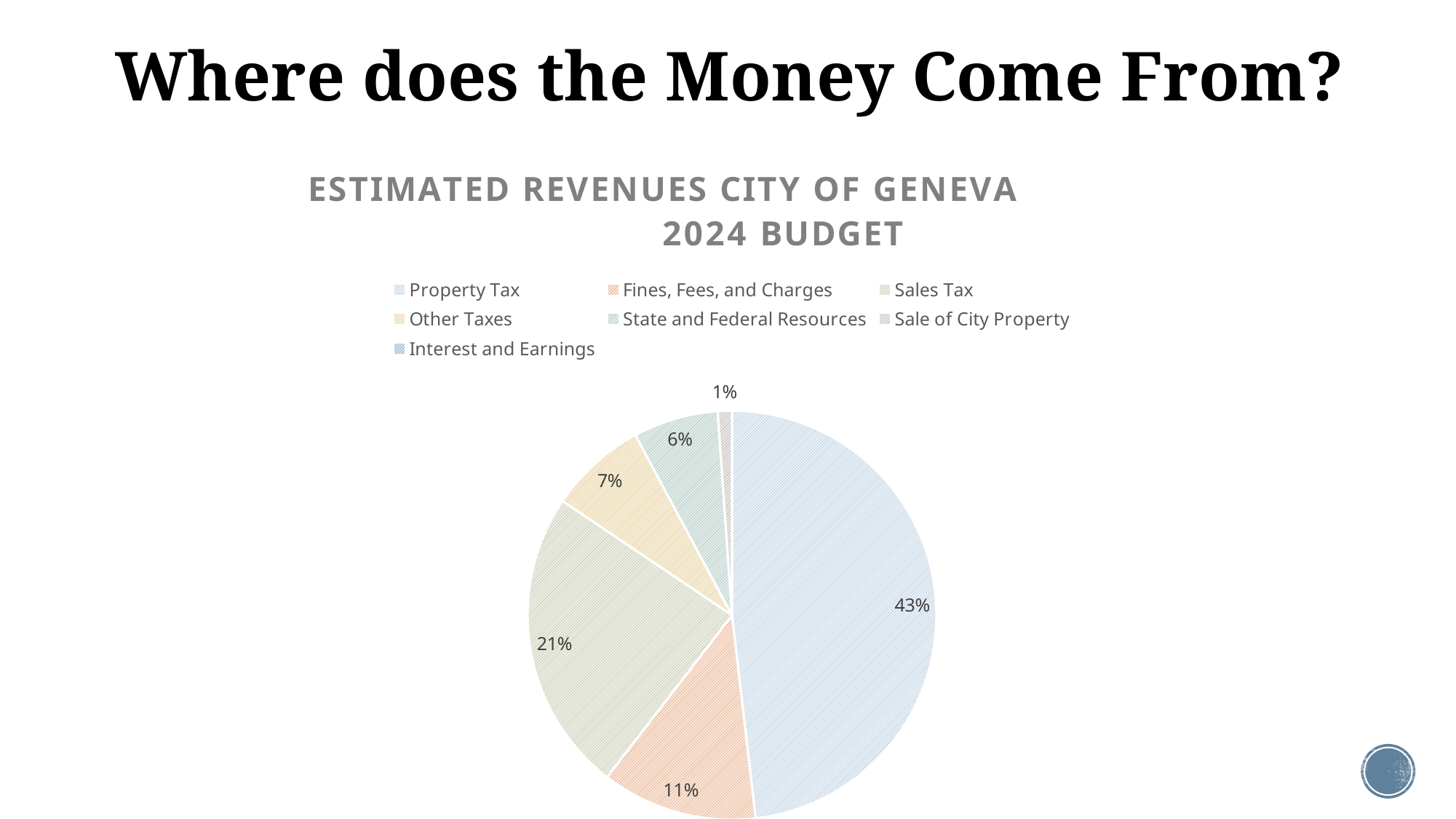
What is the difference in percentage points between Property Tax and Sales Tax? 22 What percentage does Other Taxes account for? 7% What share of estimated revenues comes from Property Tax? 43% What type of chart is shown on the slide? pie chart How many revenue sources does the legend list? 7 What is the title of the chart? Estimated Revenues City of Geneva 2024 Budget What percentage is shown for Sale of City Property? 1% Which revenue source has the largest share of the pie? Property Tax What share is labelled for Fines, Fees, and Charges? 11% What percentage of the pie is Sales Tax? 21% What share of revenues comes from State and Federal Resources? 6% Which is larger, the share for Other Taxes or the share for State and Federal Resources? Other Taxes